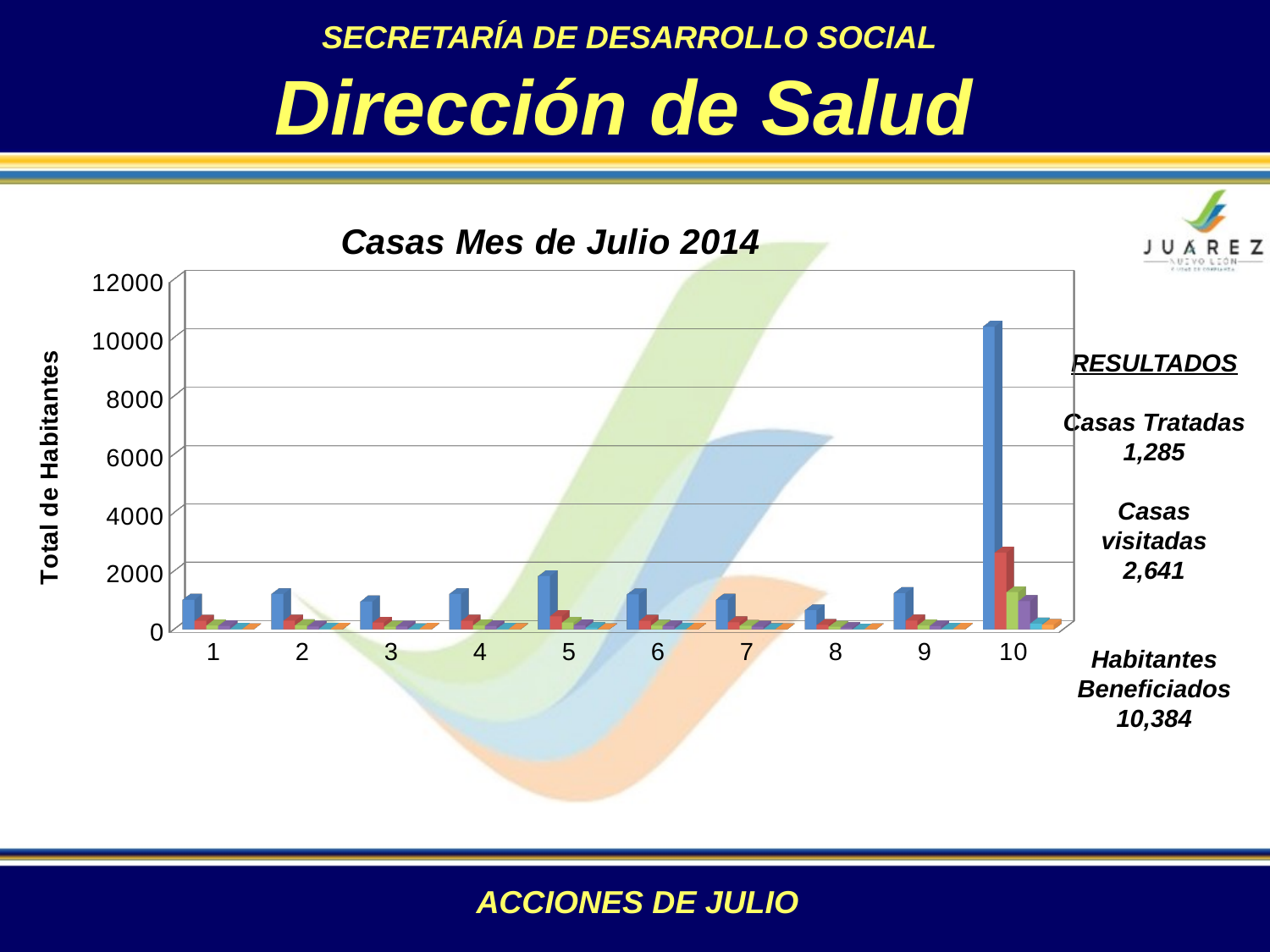
What is the title of the chart? Casas Mes de Julio 2014 Which category has the tallest bar in the chart? 10 What is the highest value shown on the vertical axis of the chart? 12000 What is the label of the vertical axis of the chart? Total de Habitantes Is the tallest bar for category 1 greater or less than 2000? less How many categories are shown along the x axis of the chart? 10 What kind of chart is shown on the slide? bar chart Which has a taller blue bar, category 5 or category 8? 5 Which has a taller blue bar, category 10 or category 1? 10 Is the tallest bar for category 5 greater or less than 4000? less Is the tallest bar for category 10 greater or less than 8000? greater